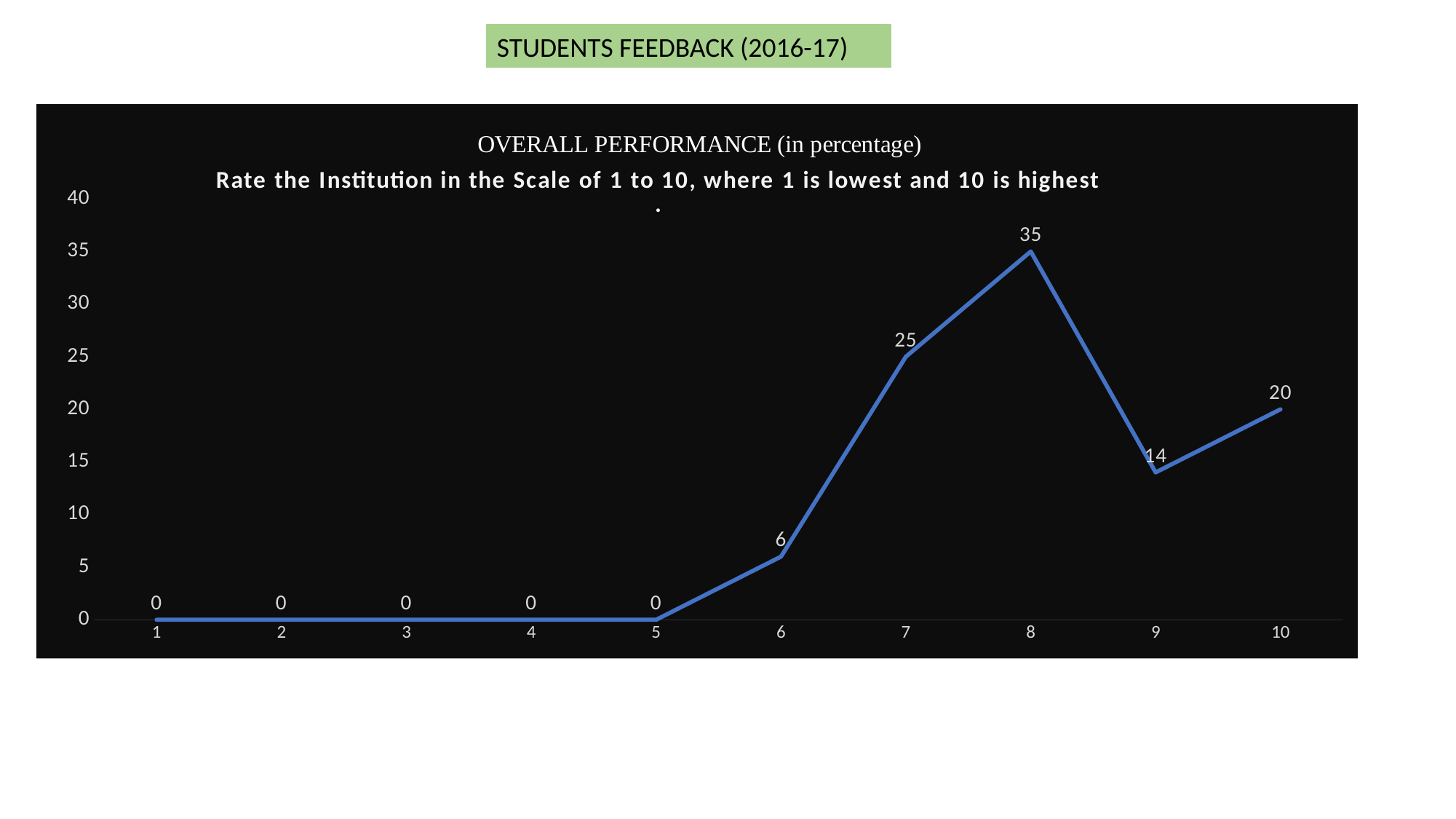
Do the values rise or fall from rating 8 to rating 9? fall What is the difference between the values for rating 7 and rating 9? 11 What is the difference between the values for rating 8 and rating 10? 15 How many rating points are plotted on the x axis? 10 Which is larger, the value for rating 10 or the value for rating 9? rating 10 What is the value for rating 8? 35 What kind of chart is shown? line chart Which rating has the highest value? 8 What is the title of the chart? Rate the Institution in the Scale of 1 to 10, where 1 is lowest and 10 is highest What is the value for rating 7? 25 What is the value for rating 9? 14 What is the value for rating 6? 6